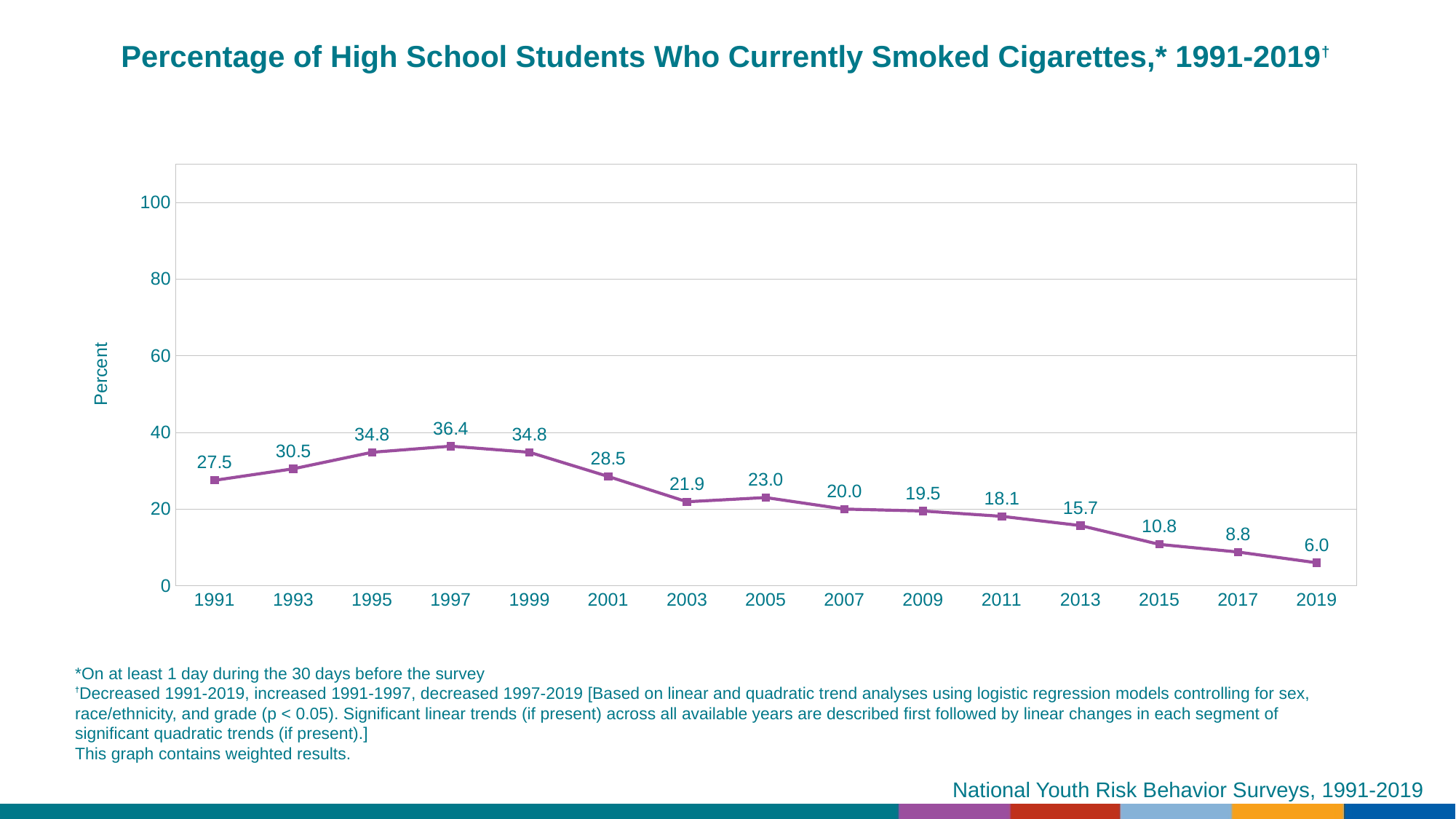
What percentage of high school students currently smoked cigarettes in 1997? 36.4 Which year has a larger value, 2003 or 2005? 2005 What is the value shown for 2005? 23.0 How many years are plotted on the x axis? 15 What is the value shown for 2019? 6.0 Do the values rise or fall from 1997 to 2019? fall Is the value for 2001 greater or less than 20? greater What is the difference between the 1991 value and the 2019 value? 21.5 What kind of chart is shown on the slide? line chart What is the difference between the 2013 value and the 2015 value? 4.9 Which year has the lowest percentage? 2019 Which year has the highest percentage? 1997